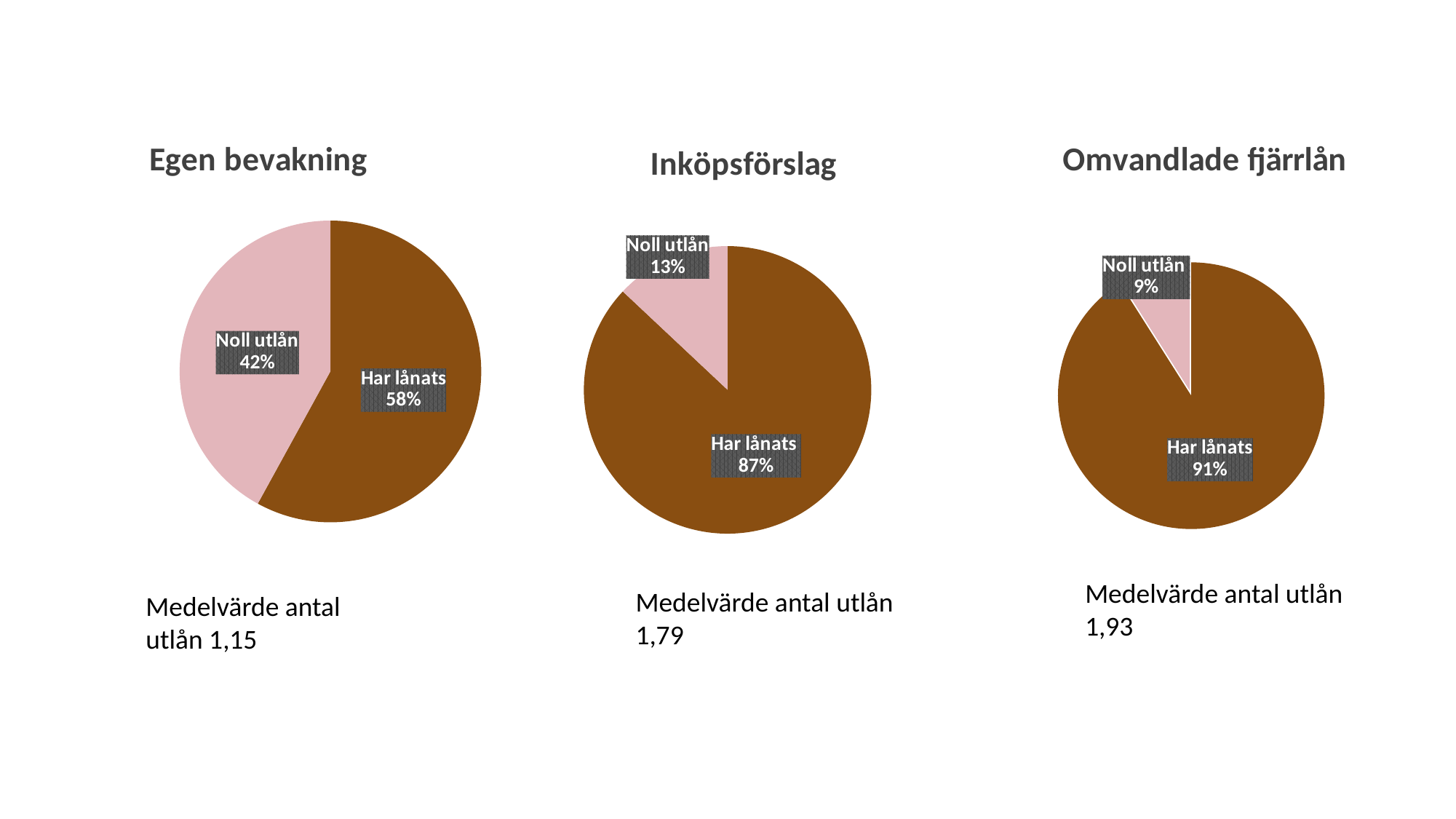
In the 'Omvandlade fjärrlån' chart, what share of the pie is 'Noll utlån'? 9% In the 'Omvandlade fjärrlån' chart, what share of the pie is 'Har lånats'? 91% In the 'Omvandlade fjärrlån' chart, which slice is the smallest? Noll utlån In the 'Inköpsförslag' chart, what share of the pie is 'Har lånats'? 87% How many slices does the 'Inköpsförslag' pie chart have? 2 What kind of chart is the 'Egen bevakning' chart? Pie chart In the 'Inköpsförslag' chart, what is the difference in percentage points between 'Har lånats' and 'Noll utlån'? 74 In the 'Egen bevakning' chart, which slice is larger, 'Har lånats' or 'Noll utlån'? Har lånats How many pie charts are shown on the slide? 3